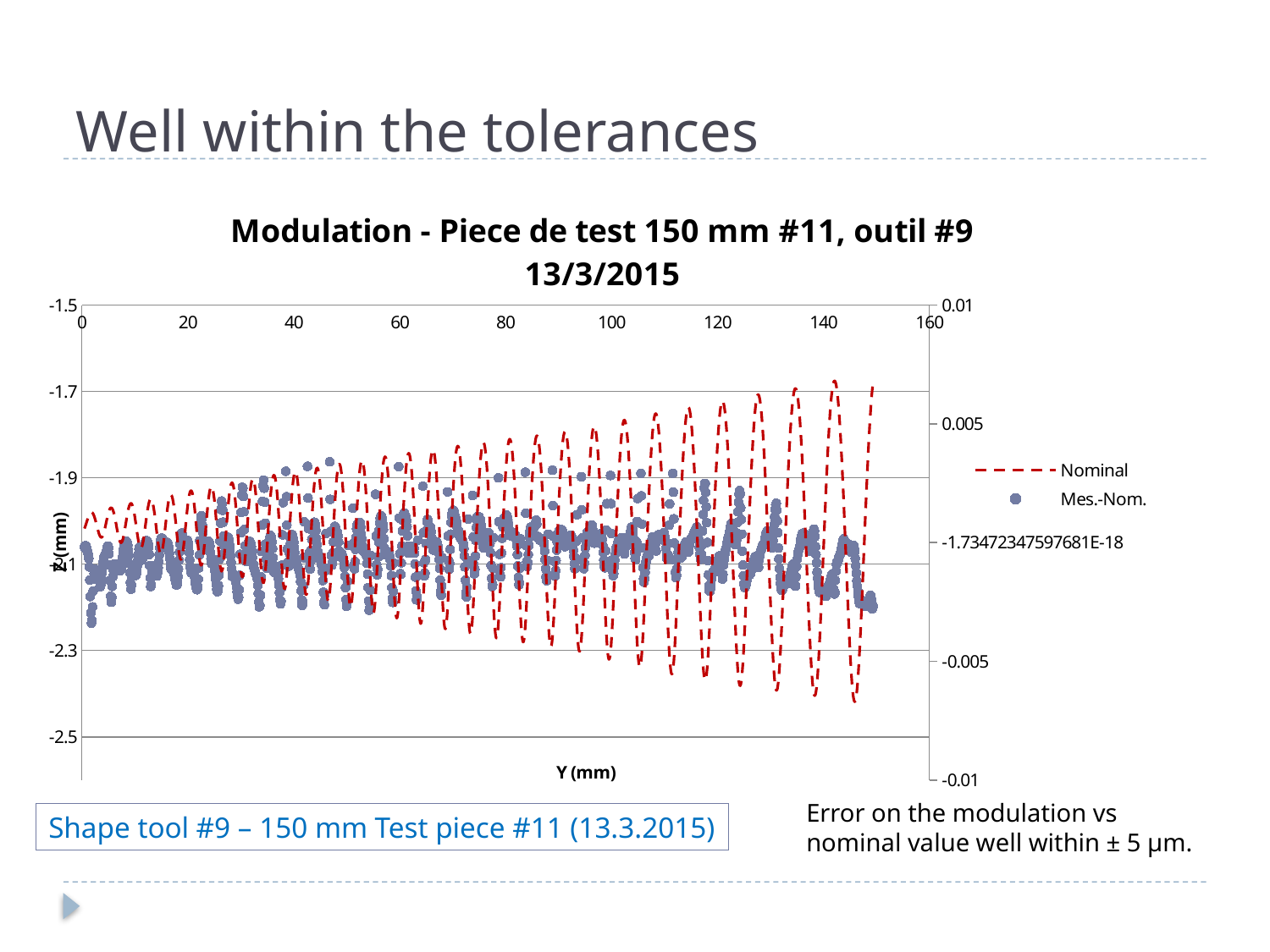
How many series does the chart legend list? 2 Is the highest value reached by the Nominal series on the left axis greater or less than -1.9? greater Is the largest Y value at which data is plotted greater or less than 140? greater What are the two series named in the chart legend? Nominal and Mes.-Nom. What is the label of the horizontal axis of the chart? Y (mm) What kind of chart is shown on the slide? scatter chart Which series is drawn as a dashed red line, Nominal or Mes.-Nom.? Nominal Is the lowest value reached by the Nominal series on the left axis greater or less than -2.3? less As Y increases along the x axis, does the amplitude of the Nominal oscillation increase or decrease? increase